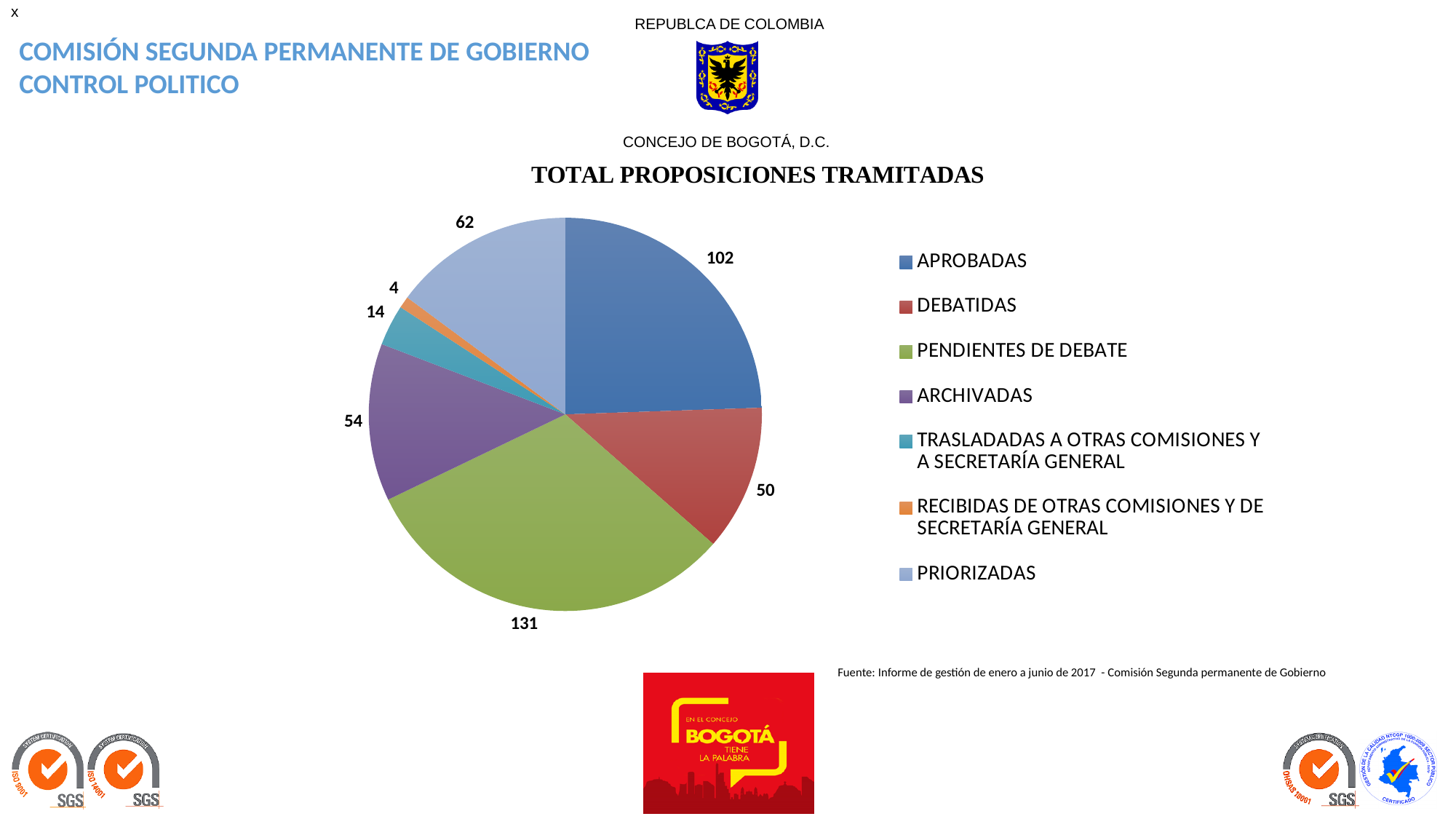
What is the difference between the values for ARCHIVADAS and DEBATIDAS? 4 What is the value for PENDIENTES DE DEBATE? 131 Which category has the smallest slice of the pie? RECIBIDAS DE OTRAS COMISIONES Y DE SECRETARÍA GENERAL What is the value for RECIBIDAS DE OTRAS COMISIONES Y DE SECRETARÍA GENERAL? 4 What is the title of the chart? TOTAL PROPOSICIONES TRAMITADAS How many categories are shown in the pie chart? 7 What is the value for APROBADAS in the pie chart? 102 What is the difference between the values for PENDIENTES DE DEBATE and APROBADAS? 29 What kind of chart is shown on the slide? Pie chart Which is larger, the value for PRIORIZADAS or the value for ARCHIVADAS? PRIORIZADAS Which category has the largest slice of the pie? PENDIENTES DE DEBATE What is the value for PRIORIZADAS? 62